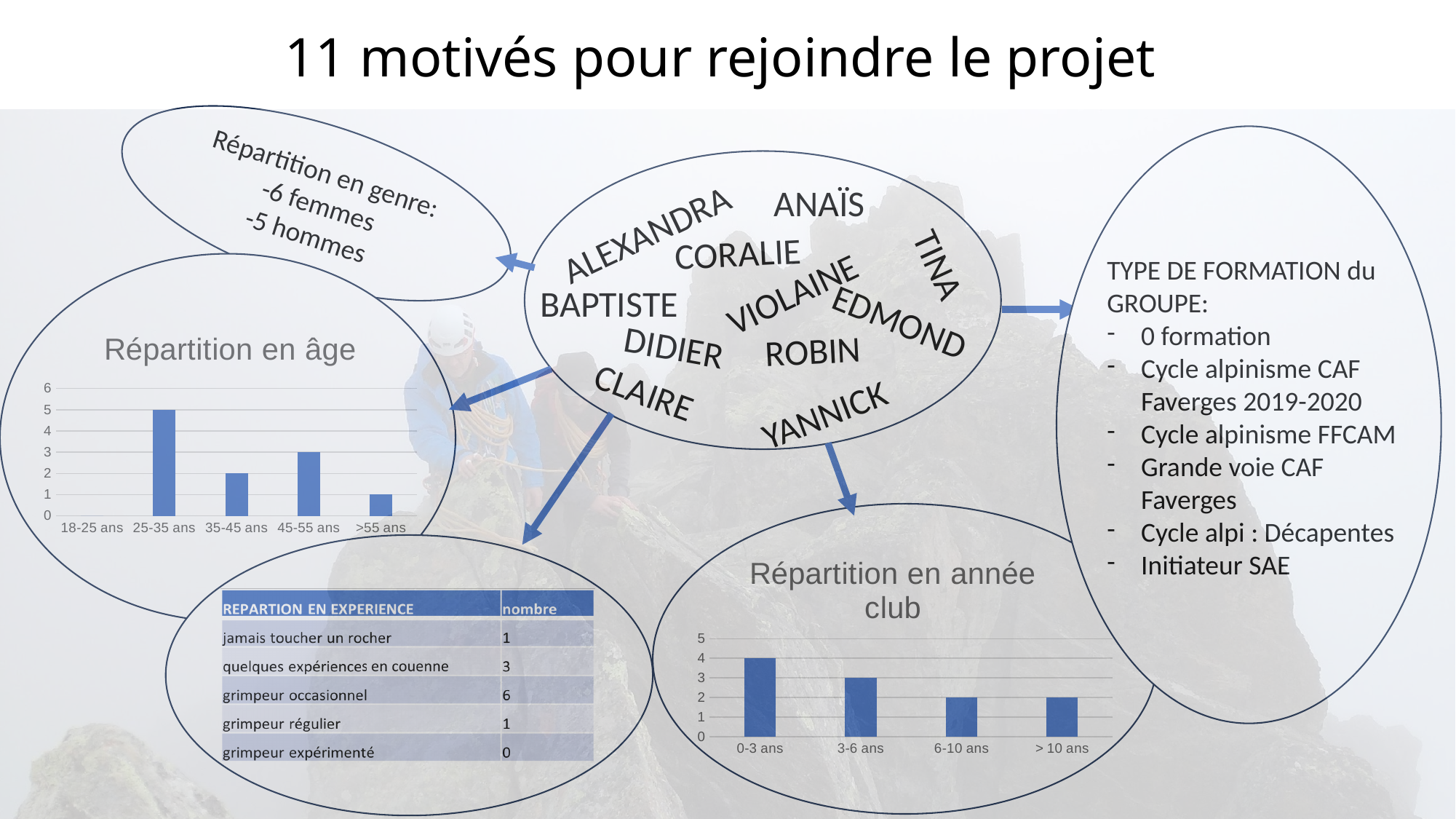
In the 'Répartition en année club' chart, do the values generally rise or fall from 0-3 ans to > 10 ans? fall In the 'Répartition en âge' chart, what is the difference between the values for 25-35 ans and 35-45 ans? 3 In the 'Répartition en âge' chart, what is the value for 45-55 ans? 3 In the 'Répartition en année club' chart, what is the value for 0-3 ans? 4 In the 'Répartition en âge' chart, which age category has the highest value? 25-35 ans In the 'Répartition en année club' chart, what is the value for 3-6 ans? 3 In the 'Répartition en âge' chart, which is larger, the value for 45-55 ans or the value for >55 ans? 45-55 ans In the 'Répartition en âge' chart, what is the value for 25-35 ans? 5 In the 'Répartition en année club' chart, how many categories are shown on the x axis? 4 In the 'Répartition en âge' chart, how many age categories are shown on the x axis? 5 What type of chart is 'Répartition en âge'? bar chart In the 'Répartition en année club' chart, which category has the highest value? 0-3 ans